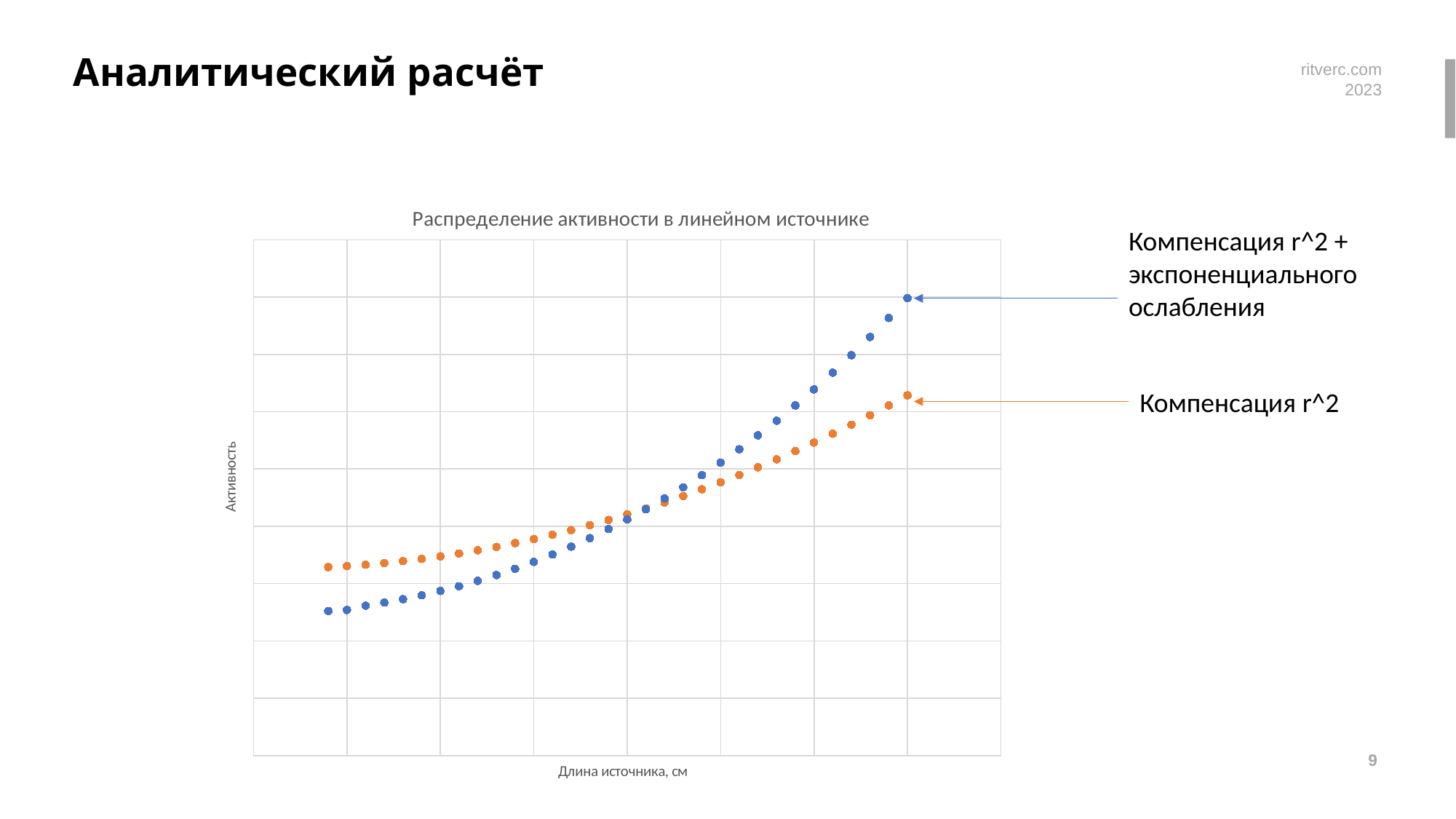
At the left end of the chart, which series has the higher activity: "Компенсация r^2" or "Компенсация r^2 + экспоненциального ослабления"? Компенсация r^2 Do the values of the series "Компенсация r^2 + экспоненциального ослабления" rise or fall along the x axis? Rise Do the two series cross each other on the chart? Yes What kind of chart is shown on the slide? Scatter chart How many data series are plotted on the chart? 2 Do the values of the series "Компенсация r^2" rise or fall as the source length increases along the x axis? Rise What is the label of the horizontal axis of the chart? Длина источника, см What is the title of the chart? Распределение активности в линейном источнике At the right end of the chart, which series has the higher activity: "Компенсация r^2" or "Компенсация r^2 + экспоненциального ослабления"? Компенсация r^2 + экспоненциального ослабления